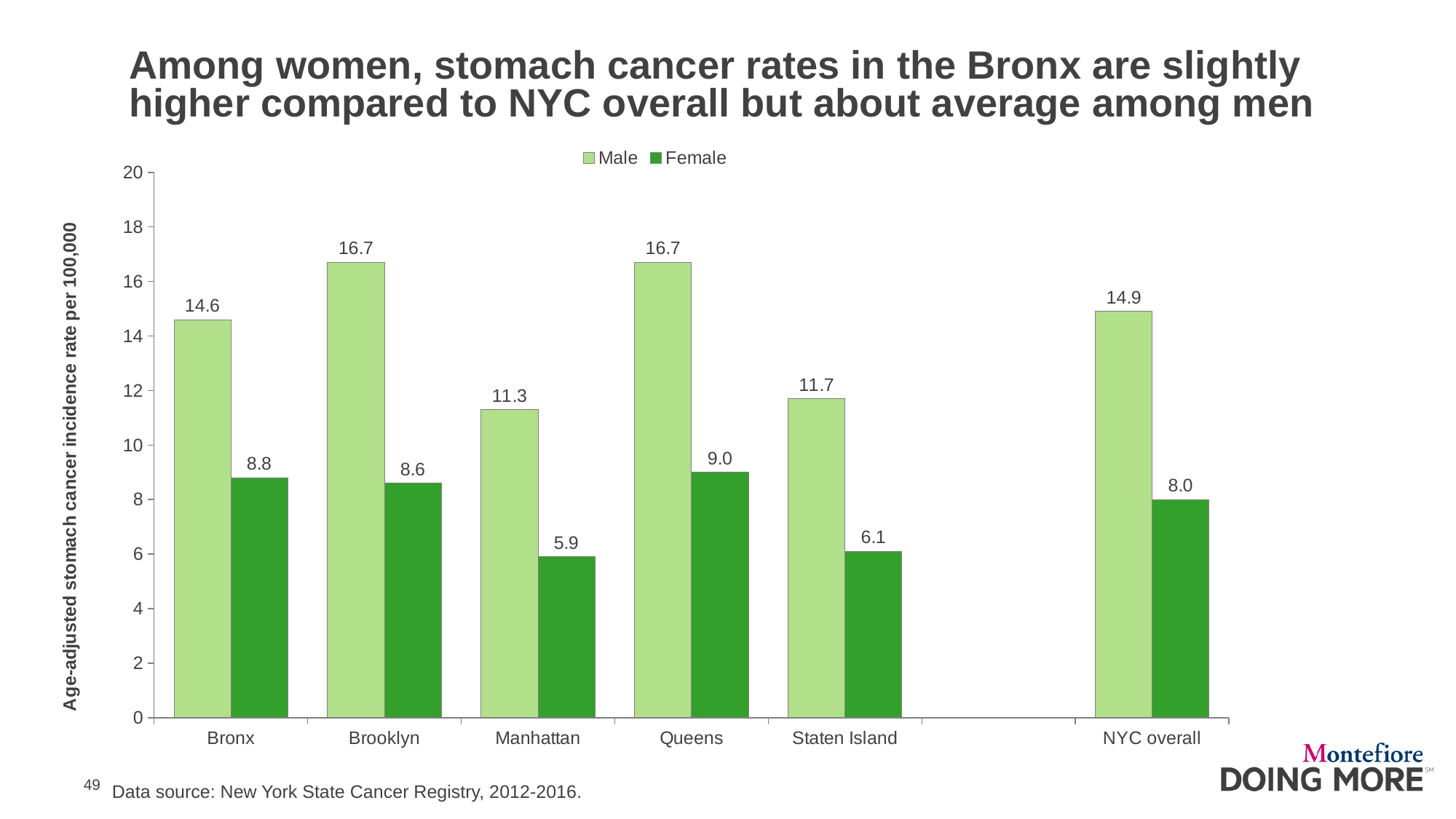
Is the Male value for Queens greater or less than 16? greater What is the Male stomach cancer incidence rate for the Bronx? 14.6 How many categories are shown on the x axis? 6 Which category has the highest Female stomach cancer incidence rate? Queens How many series does the legend list? 2 What kind of chart is shown on the slide? bar chart What is the difference between the Male and Female rates for Brooklyn? 8.1 Which borough has the lowest Male stomach cancer incidence rate? Manhattan Which is larger, the Male rate for Staten Island or the Male rate for the Bronx? Bronx What is the Female value for NYC overall? 8.0 What is the difference between the Female rate for the Bronx and the Female rate for NYC overall? 0.8 What is the Female stomach cancer incidence rate for Manhattan? 5.9